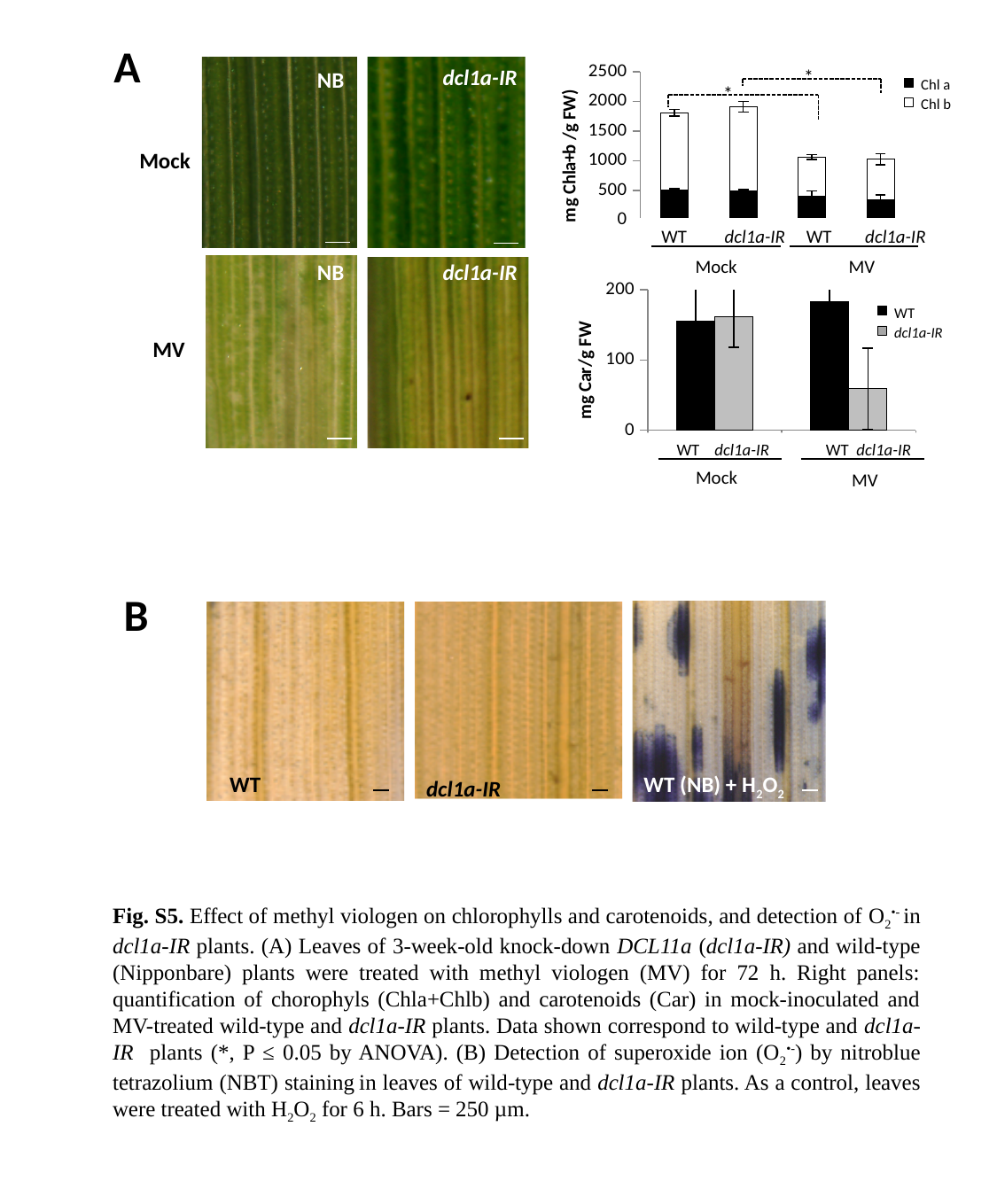
In the top chart (mg Chla+b /g FW), which has the larger total: WT under Mock or WT under MV? WT under Mock In the top chart (mg Chla+b /g FW), is the total for WT under Mock greater or less than 1500? greater How many series does the legend of the top chart (mg Chla+b /g FW) list? 2 What are the two legend entries of the top chart (mg Chla+b /g FW)? Chl a and Chl b In the bottom chart (mg Car/g FW), which is larger under MV: WT or dcl1a-IR? WT How many series does the legend of the bottom chart (mg Car/g FW) list? 2 In the bottom chart (mg Car/g FW), is the value for WT under MV greater or less than 100? greater In the top chart (mg Chla+b /g FW), is the total for WT under MV greater or less than 1500? less How many bars are plotted in the bottom chart (mg Car/g FW)? 4 In the bottom chart (mg Car/g FW), which bar is the lowest? dcl1a-IR under MV What kind of chart is the top chart (mg Chla+b /g FW)? bar chart